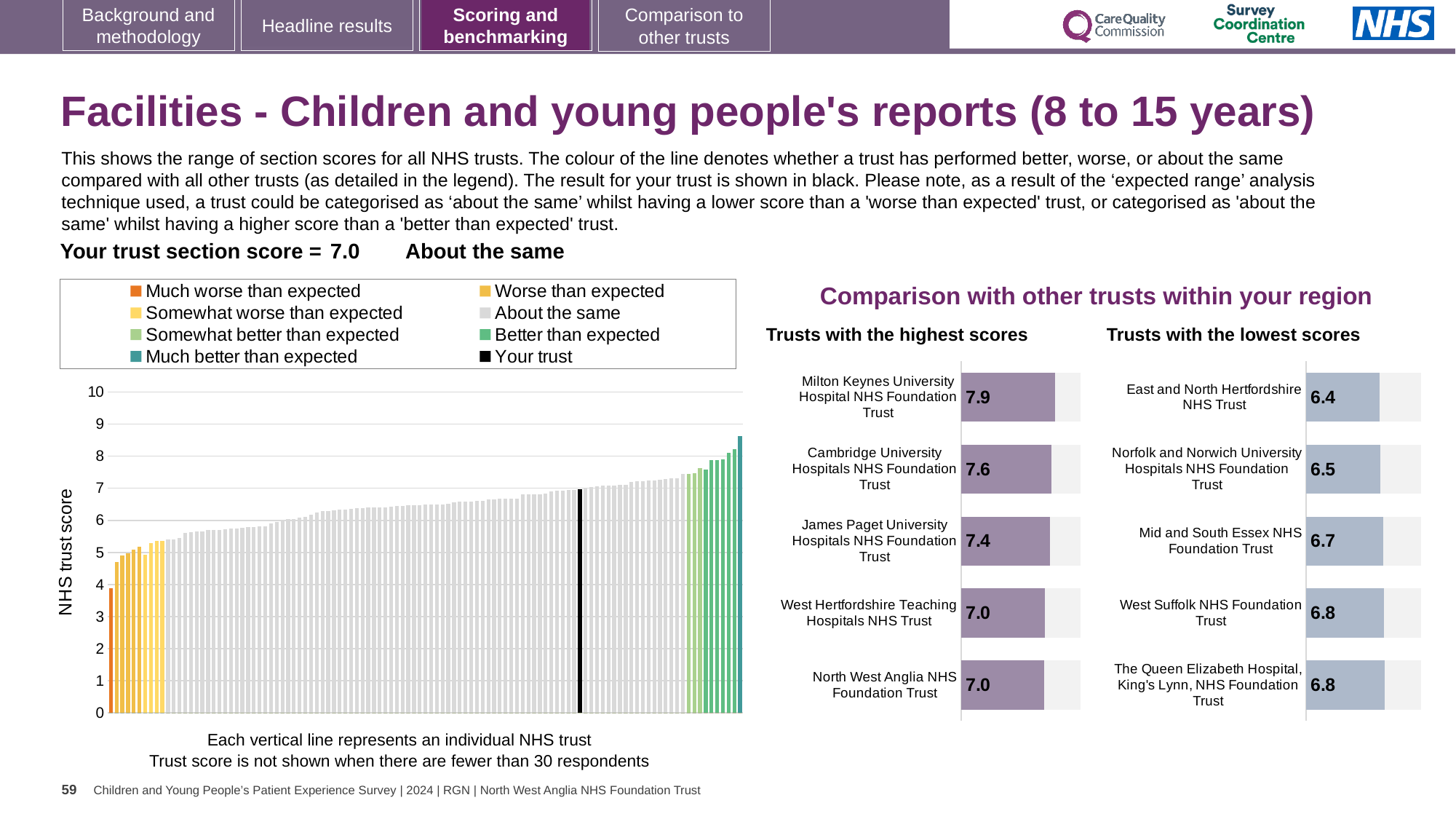
In the 'Trusts with the lowest scores' chart, what is the score for Mid and South Essex NHS Foundation Trust? 6.7 In the 'Trusts with the lowest scores' chart, which trust has the lowest score? East and North Hertfordshire NHS Trust How many entries does the legend of the main 'NHS trust score' chart list? 8 How many trusts are shown in the 'Trusts with the highest scores' chart? 5 What kind of chart is the main chart on the left showing NHS trust scores? Bar chart In the 'Trusts with the highest scores' chart, what is the difference between the scores of Milton Keynes University Hospital NHS Foundation Trust and Cambridge University Hospitals NHS Foundation Trust? 0.3 In the 'Trusts with the highest scores' chart, which trust has the highest score? Milton Keynes University Hospital NHS Foundation Trust In the 'Trusts with the highest scores' chart, what is the score for James Paget University Hospitals NHS Foundation Trust? 7.4 In the 'Trusts with the lowest scores' chart, what is the score for East and North Hertfordshire NHS Trust? 6.4 In the 'Trusts with the highest scores' chart, what is the score for Milton Keynes University Hospital NHS Foundation Trust? 7.9 In the main 'NHS trust score' chart, is the value of the tallest bar on the right greater or less than 8? greater In the 'Trusts with the lowest scores' chart, which has the larger score: Norfolk and Norwich University Hospitals NHS Foundation Trust or West Suffolk NHS Foundation Trust? West Suffolk NHS Foundation Trust